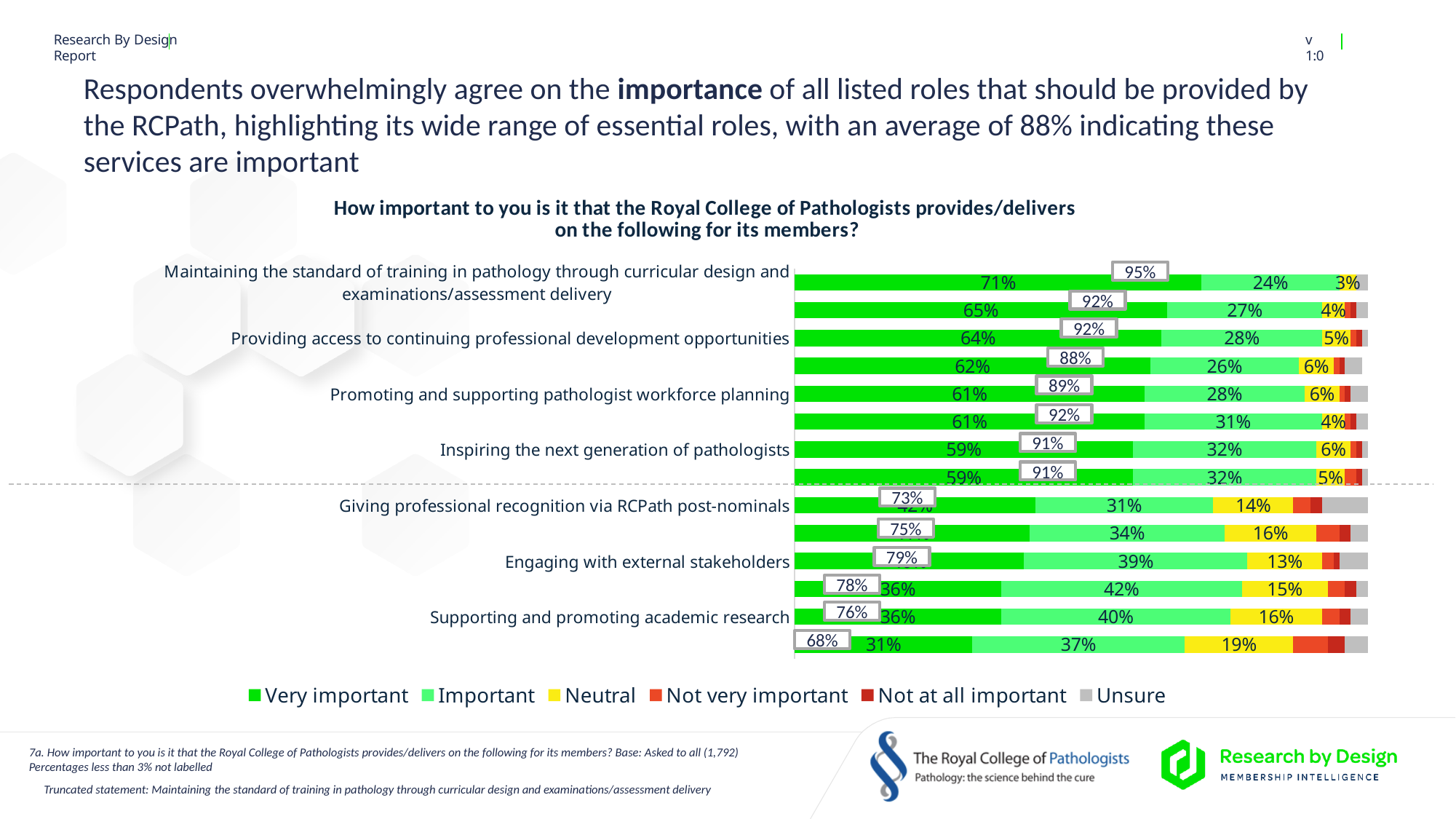
What is the Neutral value for 'Giving professional recognition via RCPath post-nominals'? 14% Which has a larger Important percentage: 'Inspiring the next generation of pathologists' or 'Providing access to continuing professional development opportunities'? Inspiring the next generation of pathologists What kind of chart is shown on the slide? Stacked bar chart What is the Important value for 'Engaging with external stakeholders'? 39% How many series does the legend list? 6 What is the Neutral value for 'Promoting and supporting pathologist workforce planning'? 6% Which labelled category has the highest Very important percentage? Maintaining the standard of training in pathology through curricular design and examinations/assessment delivery Which colour represents the Neutral series in the legend? Yellow What percentage of respondents rated 'Maintaining the standard of training in pathology through curricular design and examinations/assessment delivery' as Very important? 71% What is the Important value for 'Providing access to continuing professional development opportunities'? 28% What is the difference in the Very important percentage between 'Maintaining the standard of training in pathology through curricular design and examinations/assessment delivery' (71%) and 'Providing access to continuing professional development opportunities' (64%)? 7 percentage points What combined importance figure is shown in the box for 'Inspiring the next generation of pathologists'? 91%